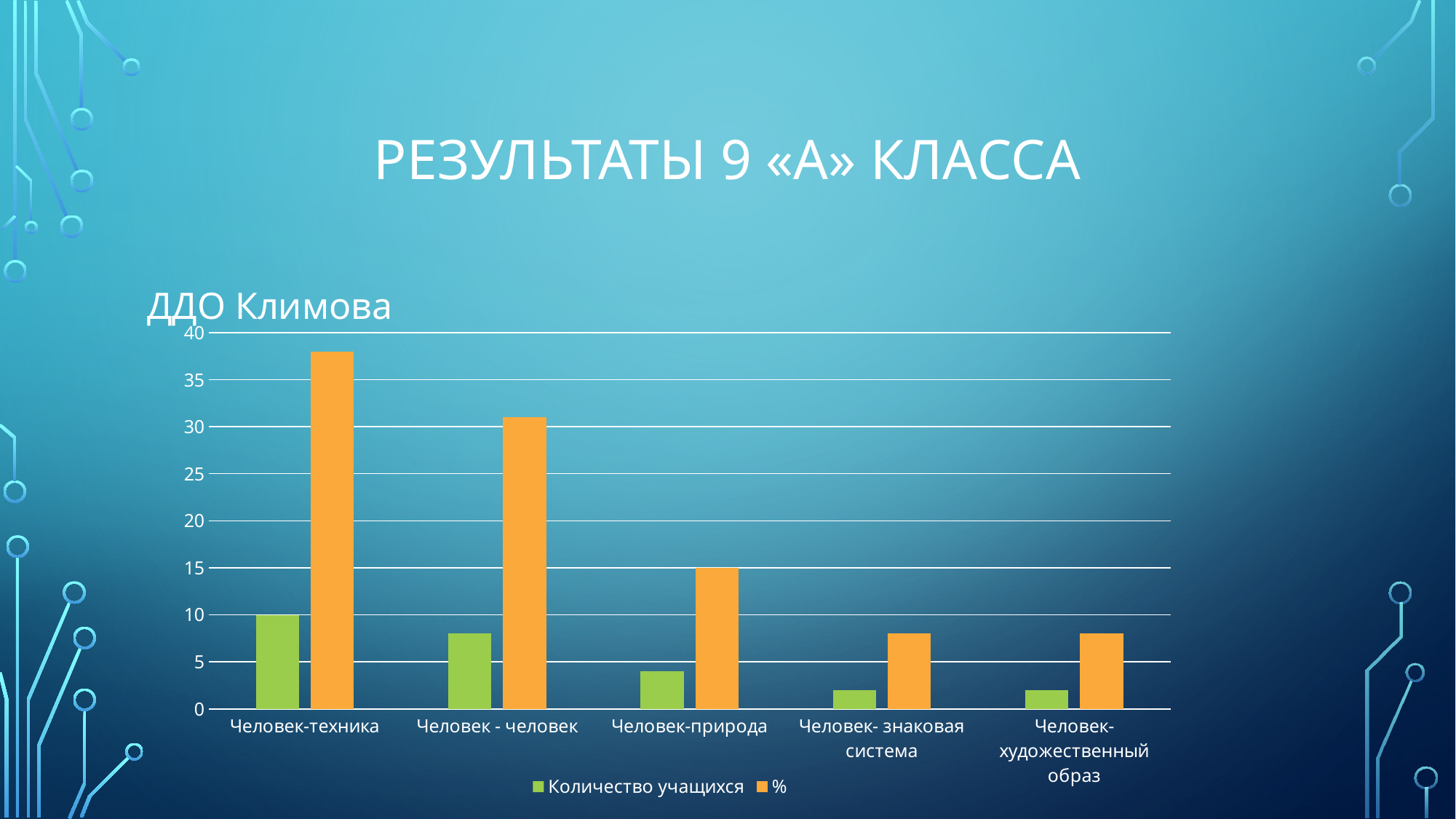
Which is larger, the % value for Человек - человек or the % value for Человек-природа? Человек - человек How many series does the legend list? 2 What type of chart is shown on the slide? bar chart Is the Количество учащихся value for Человек-природа greater or less than 5? less Which category has the highest % value? Человек-техника What is the % value for Человек-природа? 15 Which category has the lowest Количество учащихся value? Человек- знаковая система and Человек-художественный образ Is the % value for Человек-техника greater or less than 35? greater What is the title of the chart? ДДО Климова Is the % value for Человек - человек greater or less than 30? greater How many categories are shown on the x axis? 5 What is the value of Количество учащихся for Человек-техника? 10